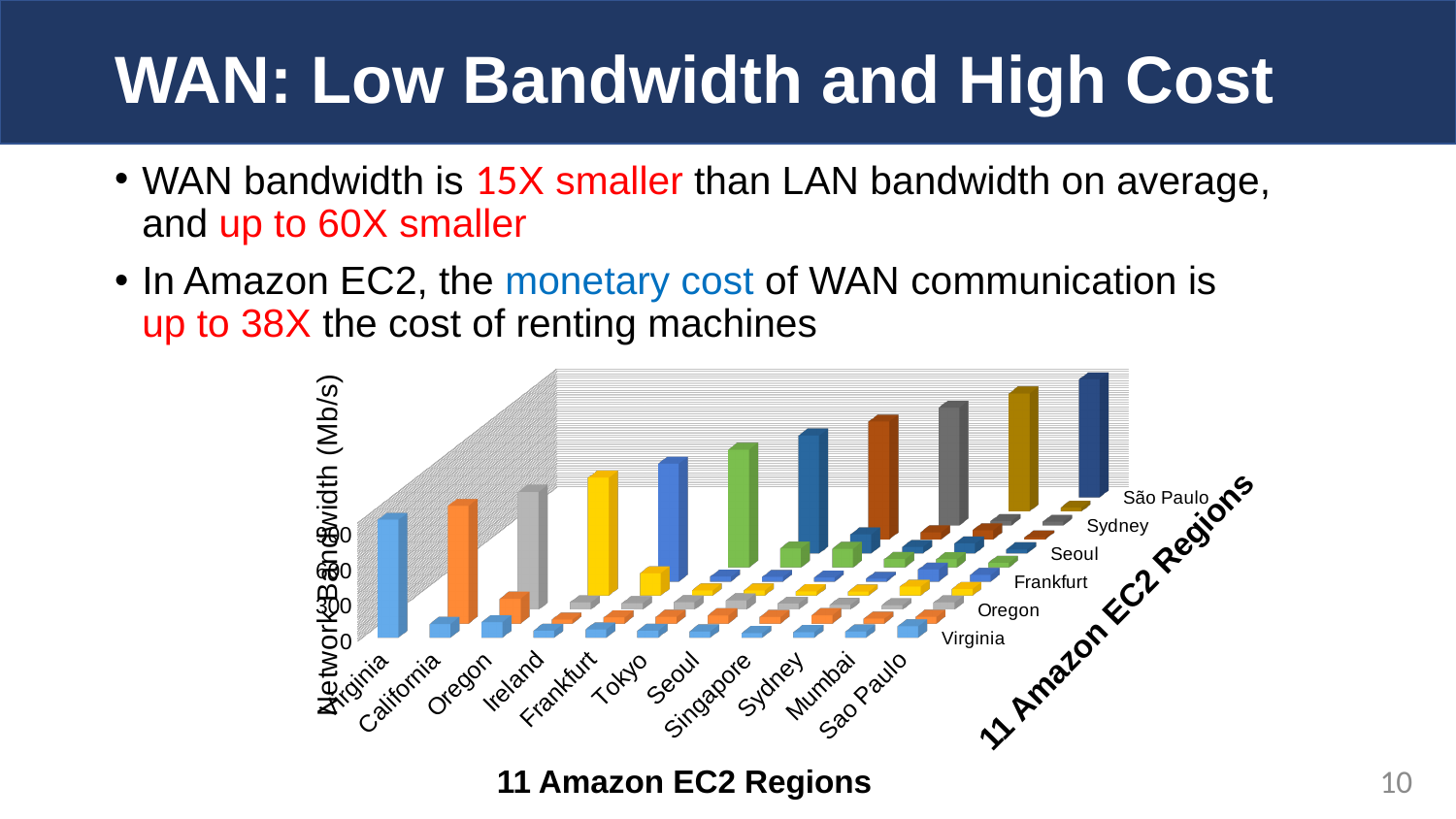
What kind of chart is shown on the slide? bar chart How many Amazon EC2 regions are listed along the front (x) axis of the chart? 11 Which region is the first category on the front (x) axis of the chart? Virginia What is the title of the vertical axis of the chart? Network Bandwidth (Mb/s) Which region label comes immediately after Frankfurt on the front (x) axis of the chart? Tokyo Which region label appears at the far end of the chart's depth axis, after Sydney? São Paulo What is the title printed below the chart's front axis? 11 Amazon EC2 Regions Which region is the last category on the front (x) axis of the chart? Sao Paulo